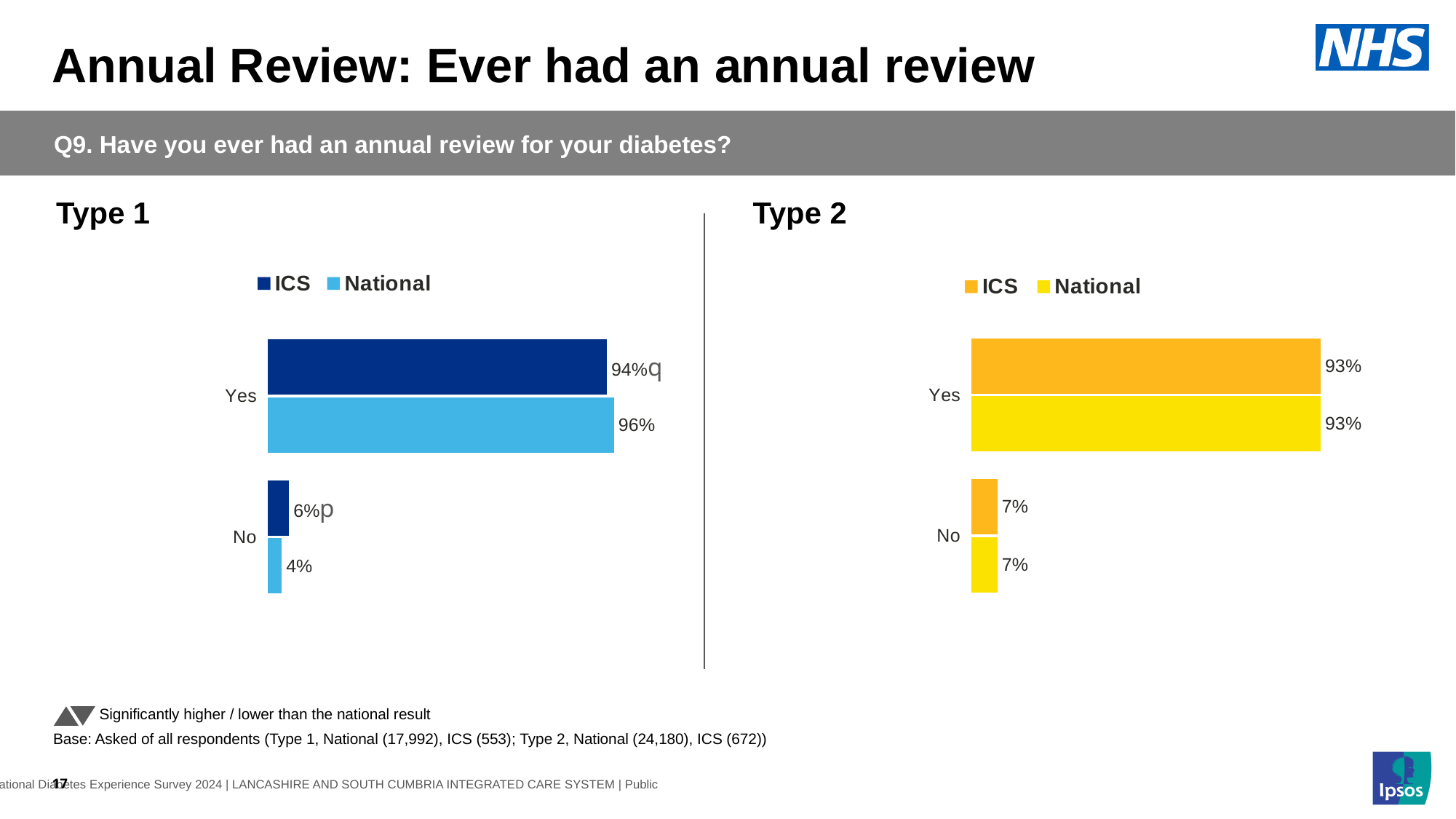
In the Type 1 chart, what is the National value for No? 4% In the Type 1 chart, what colour are the ICS bars? Dark blue In the Type 2 chart, what is the difference between the ICS and National values for Yes? 0% How many series does the legend of the Type 2 chart list? 2 In the Type 1 chart, which is larger for No, ICS or National? ICS What kind of chart is the Type 2 chart? Bar chart In the Type 1 chart, what is the ICS value for Yes? 94% In the Type 2 chart, what is the National value for No? 7% In the Type 2 chart, what is the ICS value for Yes? 93% In the Type 1 chart, which is larger for Yes, ICS or National? National How many categories are shown in the Type 1 chart? 2 In the Type 1 chart, what is the difference between the National and ICS values for Yes? 2%